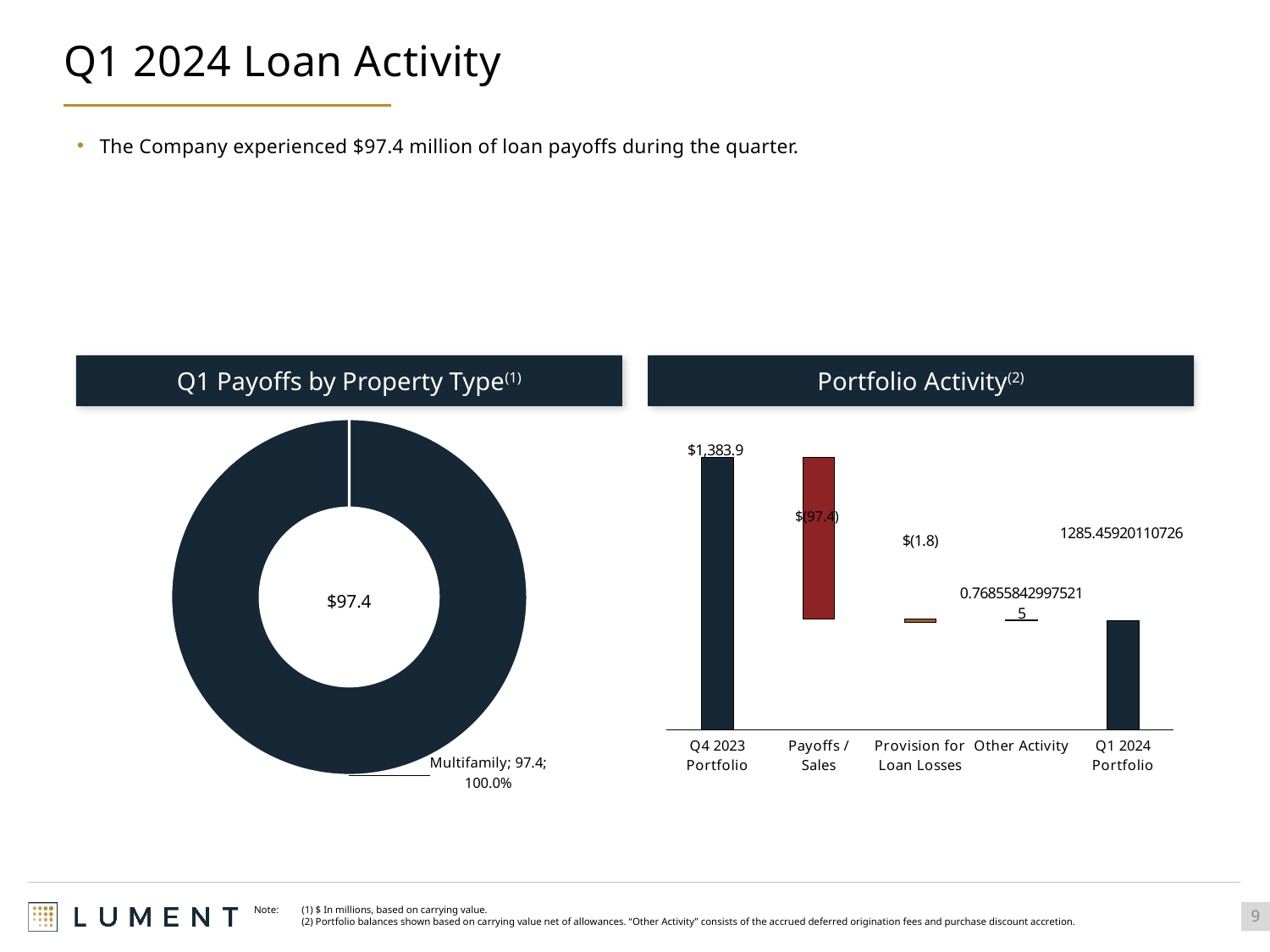
In the Portfolio Activity chart, what is the value for Q4 2023 Portfolio? $1,383.9 In the Portfolio Activity chart, what colour is the Payoffs / Sales bar? red In the Portfolio Activity chart, what is the value for Q1 2024 Portfolio? 1285.45920110726 What kind of chart is the Q1 Payoffs by Property Type chart? doughnut chart In the Portfolio Activity chart, what is the value for Provision for Loan Losses? $(1.8) In the Portfolio Activity chart, what is the value for Payoffs / Sales? $(97.4) In the Portfolio Activity chart, which is larger, the Q4 2023 Portfolio or the Q1 2024 Portfolio? Q4 2023 Portfolio In the Q1 Payoffs by Property Type chart, what is the value shown for Multifamily? 97.4 In the Q1 Payoffs by Property Type chart, what share of the pie does Multifamily represent? 100.0% How many categories are shown on the x axis of the Portfolio Activity chart? 5 What kind of chart is the Portfolio Activity chart? bar chart How many slices does the Q1 Payoffs by Property Type chart have? 1